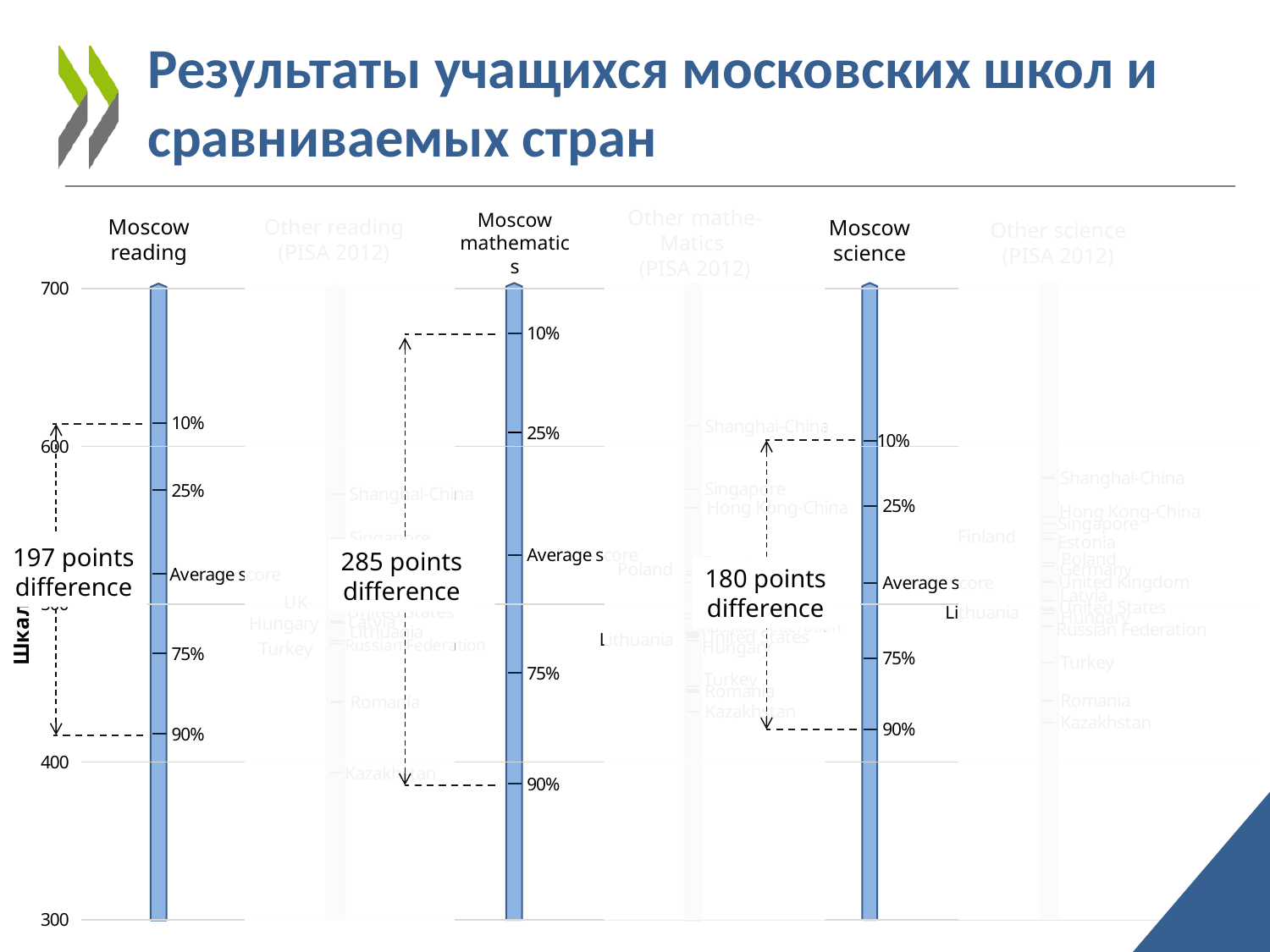
Is the points difference for Moscow reading larger or smaller than that for Moscow science? larger How much larger is the points difference for Moscow mathematics than for Moscow reading? 88 points Which Moscow subject scale shows the largest points difference? Moscow mathematics Which Moscow subject scale shows the smallest points difference? Moscow science Is the 75% marker on the Moscow mathematics scale greater or less than 500? less What is the points difference shown for Moscow reading? 197 points difference What is the points difference shown for Moscow science? 180 points difference What are the lowest and highest values shown on the vertical axis? 300 and 700 Is the 10% marker on the Moscow mathematics scale greater or less than 600? greater What is the points difference shown for Moscow mathematics? 285 points difference How much larger is the points difference for Moscow mathematics than for Moscow science? 105 points How many Moscow subject scales are plotted on the slide? 3